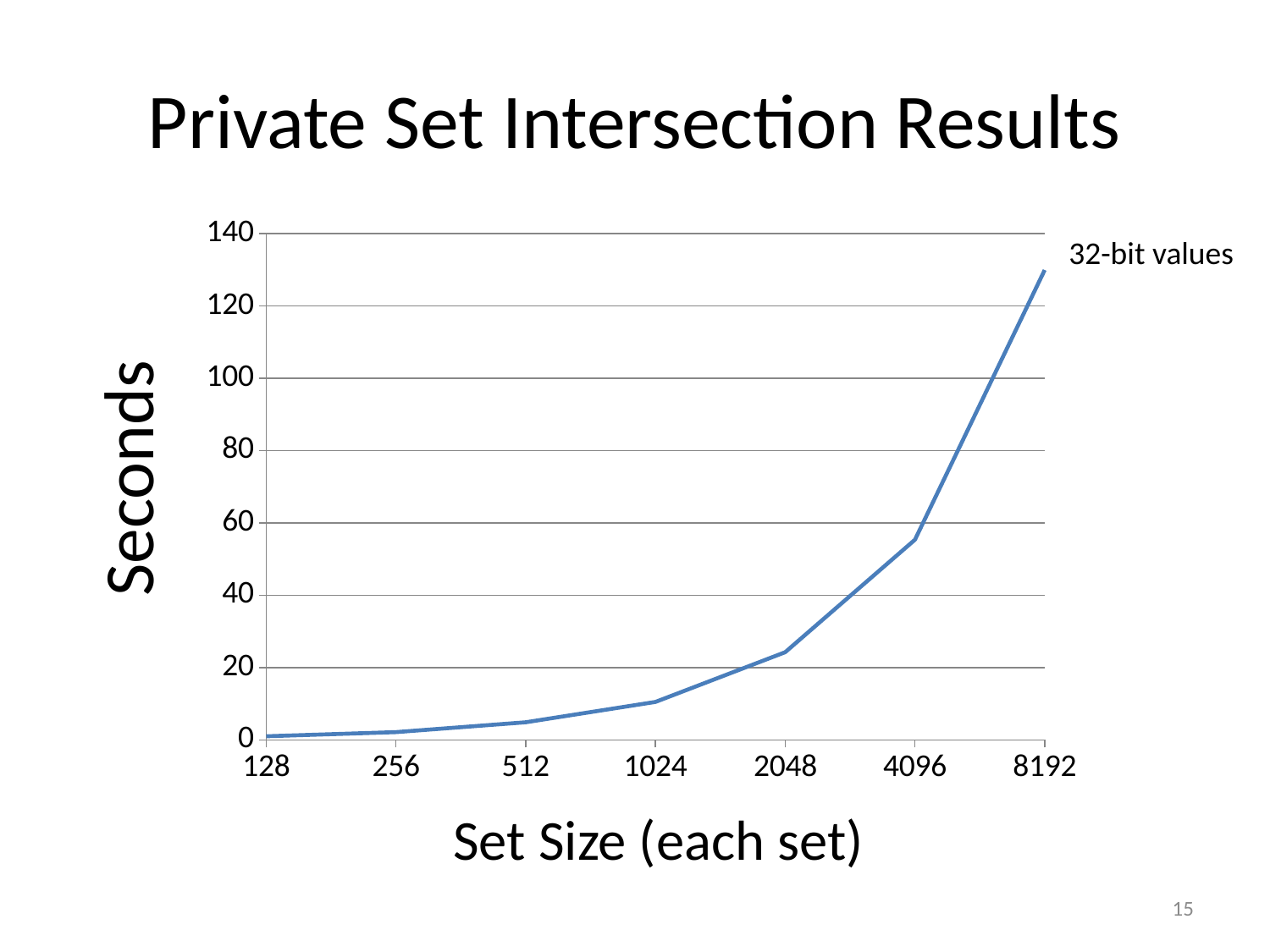
Is the value for set size 4096 greater or less than 40 seconds? greater What is the label of the y axis? Seconds Do the values rise or fall as the set size increases along the x axis? rise How many set sizes are plotted along the x axis? 7 Which has the larger value in seconds, set size 2048 or set size 4096? 4096 Is the value for set size 1024 greater or less than 20 seconds? less What is the title of the chart? Private Set Intersection Results Is the value for set size 2048 greater or less than 40 seconds? less Which set size has the highest value in seconds? 8192 Which set size has the lowest value in seconds? 128 What kind of chart is shown on the slide? line chart